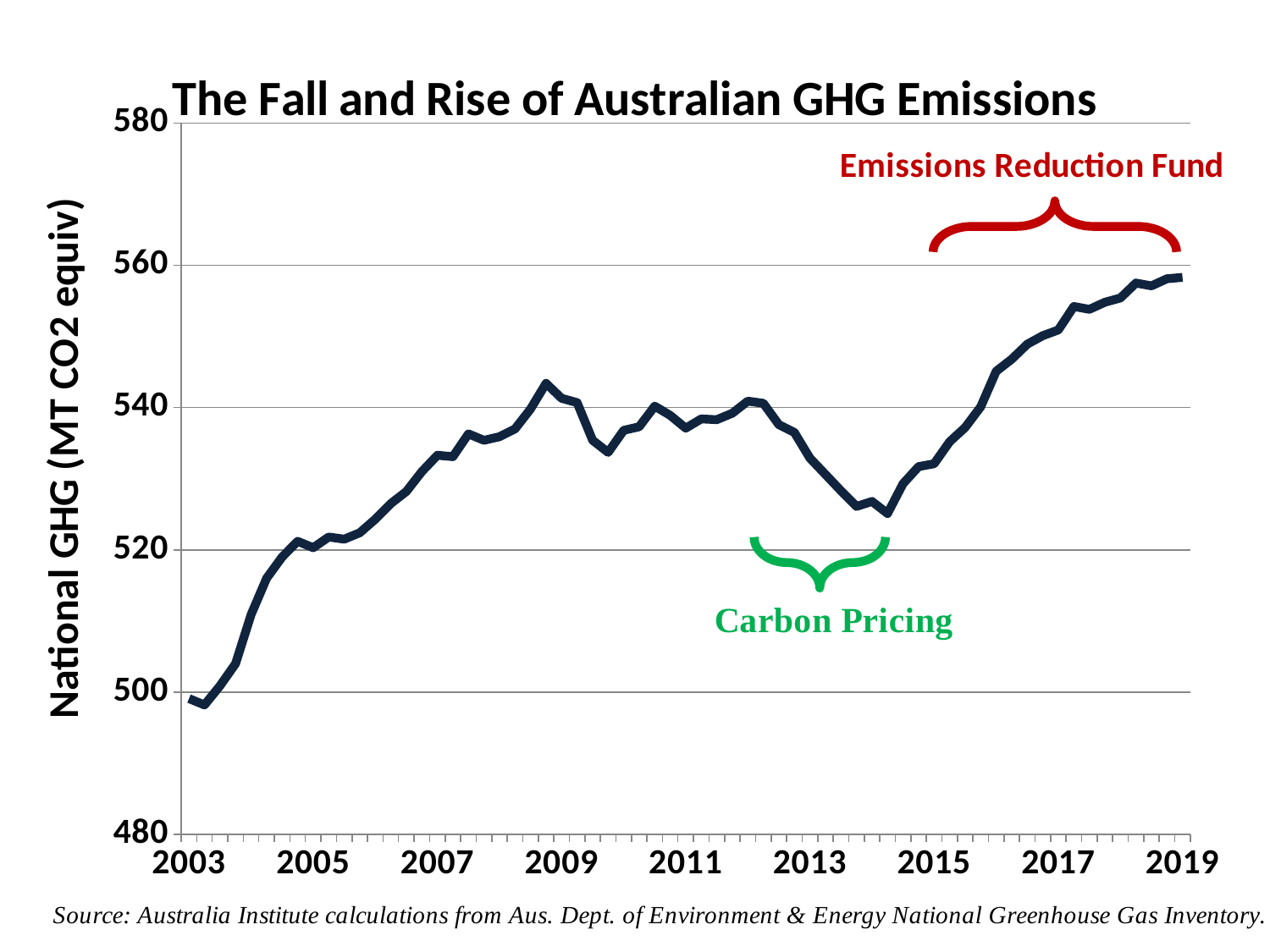
Is the value for 2003 greater or less than 520? less What kind of chart is shown on the slide? line chart What is the title of the chart? The Fall and Rise of Australian GHG Emissions Which is larger, the value for 2009 or the value for 2014? 2009 Do the values rise or fall between 2003 and 2009? rise Do the values rise or fall between 2012 and 2014? fall Do the values rise or fall between 2014 and 2019? rise Is the value for 2019 greater or less than 540? greater Is the value for 2014 greater or less than 540? less Which is larger, the value for 2019 or the value for 2003? 2019 What label does the green annotation under the dip around 2012-2014 show? Carbon Pricing